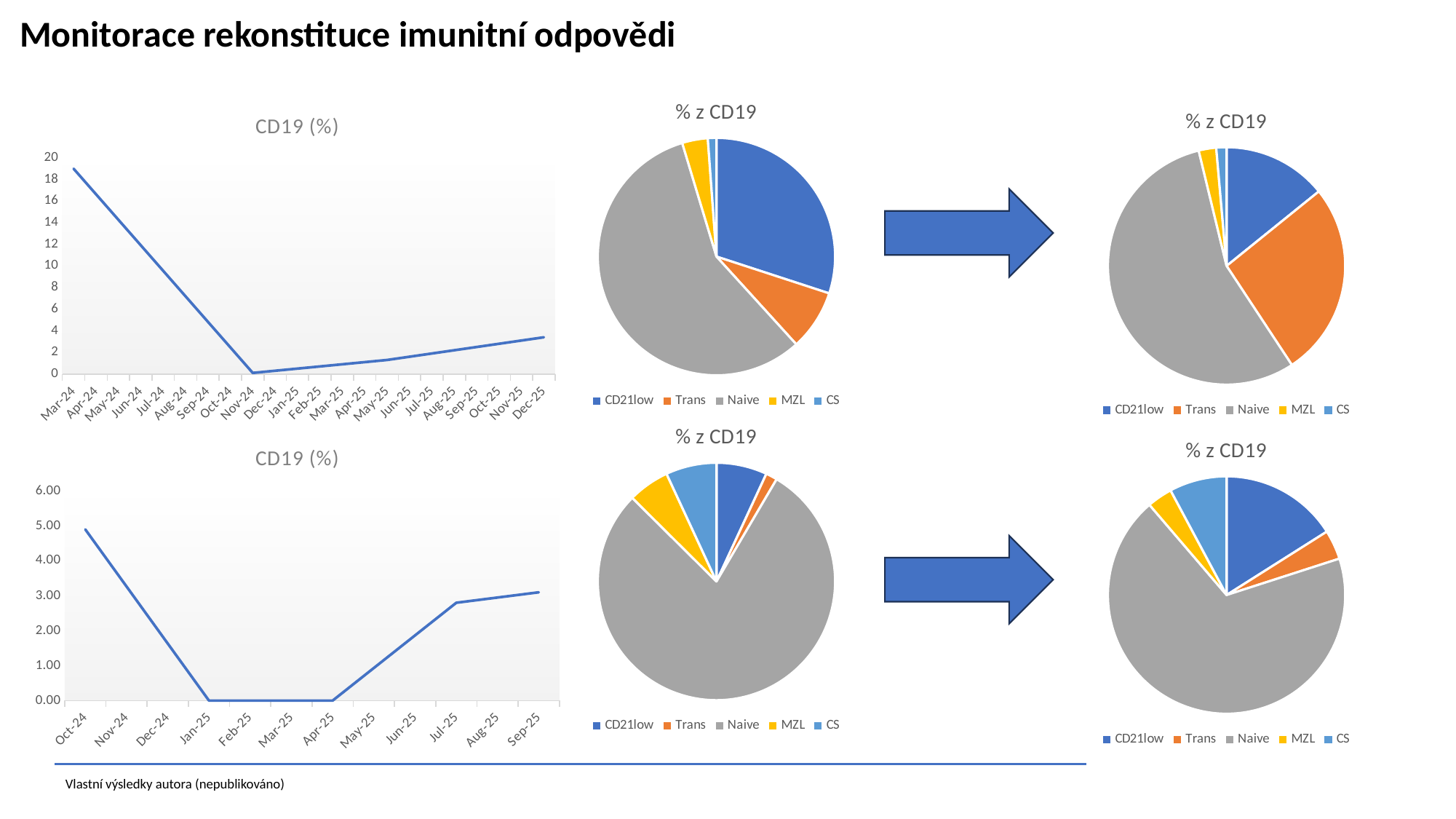
In the top-left line chart "CD19 (%)", do the values rise or fall from Mar-24 to Nov-24? fall In the bottom-left line chart "CD19 (%)", is the value for Oct-24 greater or less than 4.00? greater In the top-middle pie chart "% z CD19", which slice is larger, CD21low or Trans? CD21low How many pie charts are on the slide? 4 In the top-middle pie chart "% z CD19", which category has the largest slice? Naive What kind of chart is the top-left chart titled "CD19 (%)"? line chart In the bottom-middle pie chart "% z CD19", which category has the smallest slice? Trans What kind of chart are the four charts titled "% z CD19"? pie chart In the bottom-left line chart "CD19 (%)", is the value for Sep-25 greater or less than 2.00? greater How many entries does the legend of the top-middle pie chart "% z CD19" list? 5 In the top-left line chart "CD19 (%)", is the value for Dec-25 greater or less than 10? less